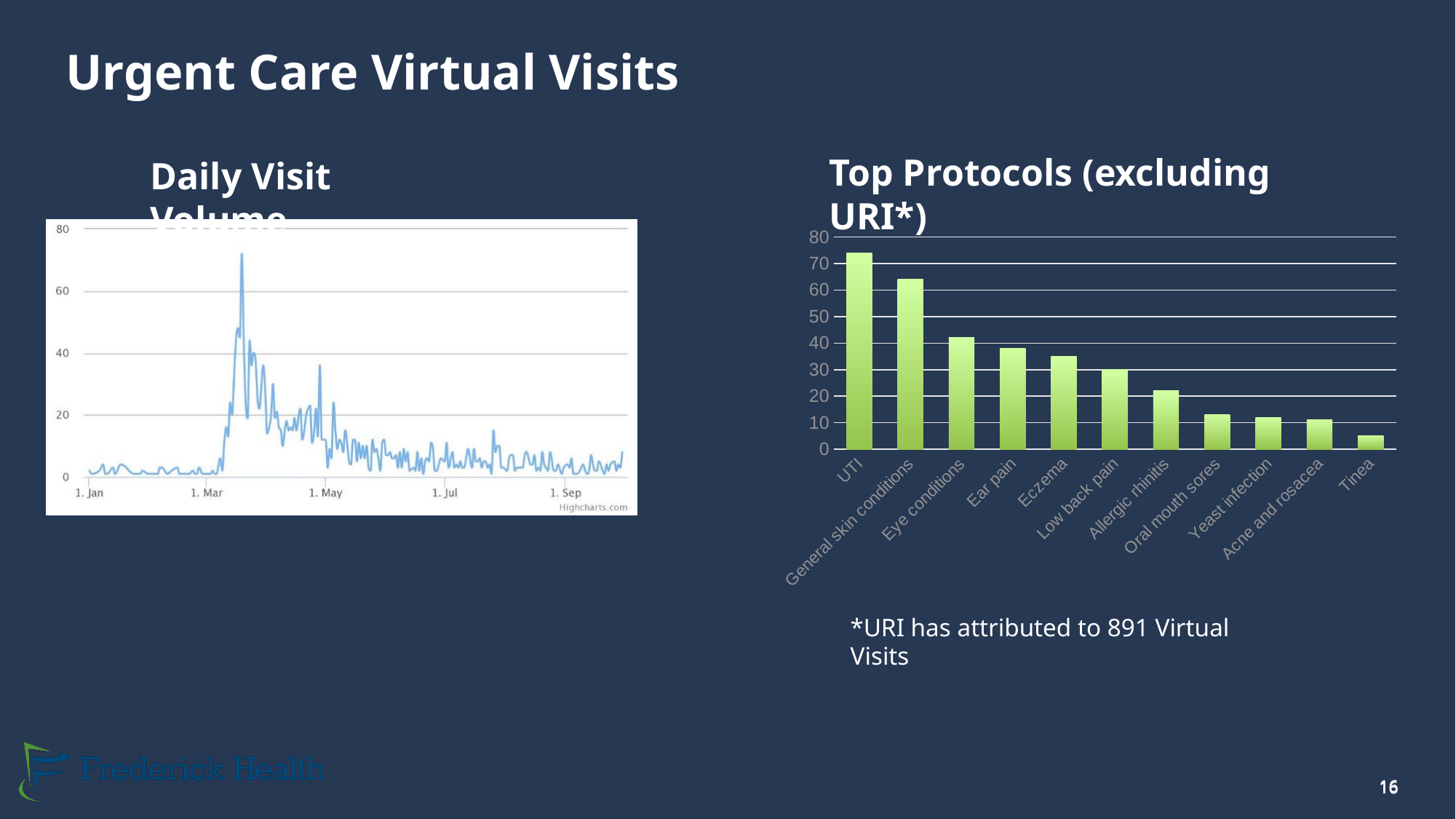
In the Top Protocols (excluding URI*) chart, is the value for Tinea greater or less than 10? less In the Daily Visit Volume chart, is the highest peak greater or less than 60? greater In the Top Protocols (excluding URI*) chart, is the value for UTI greater or less than 70? greater In the Top Protocols (excluding URI*) chart, which is larger, Eczema or Allergic rhinitis? Eczema What kind of chart is the Daily Visit Volume chart? line chart In the Top Protocols (excluding URI*) chart, which is larger, UTI or General skin conditions? UTI What kind of chart is the Top Protocols (excluding URI*) chart? bar chart In the Top Protocols (excluding URI*) chart, how many protocols are shown? 11 In the Top Protocols (excluding URI*) chart, which protocol has the highest value? UTI In the Top Protocols (excluding URI*) chart, which protocol has the lowest value? Tinea